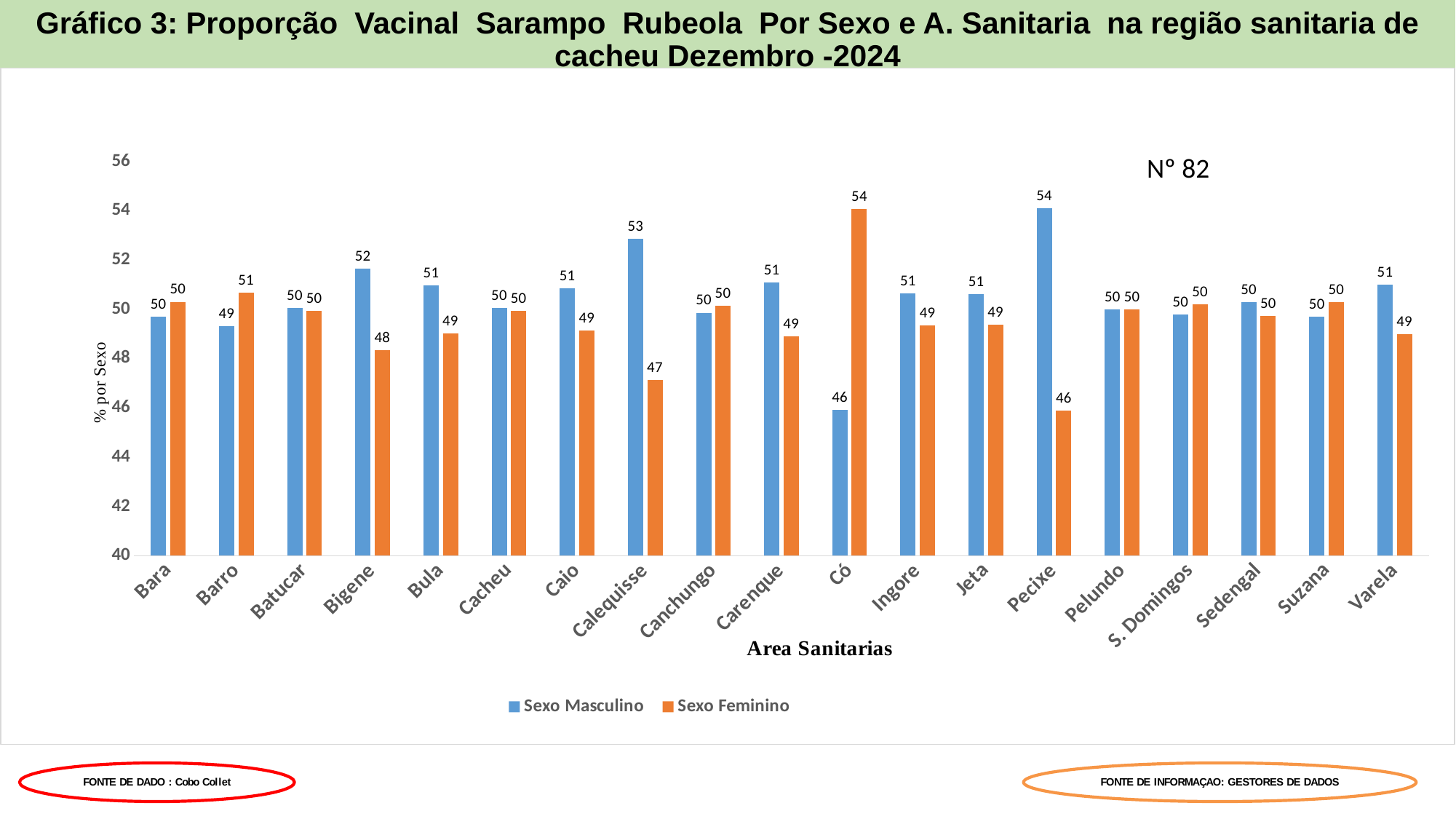
How many series does the legend list? 2 What is the difference between the Sexo Masculino and Sexo Feminino values for Calequisse? 6 What is the Sexo Feminino value for Có? 54 What kind of chart is shown on the slide? bar chart Is the Sexo Masculino value for Có greater or less than 48? less How many areas sanitarias are shown on the x axis? 19 Which area sanitaria has the lowest Sexo Feminino value? Pecixe Which is larger for Có: the Sexo Masculino value or the Sexo Feminino value? Sexo Feminino What is the Sexo Feminino value for Bigene? 48 Which area sanitaria has the highest Sexo Masculino value? Pecixe What is the Sexo Masculino value for Calequisse? 53 Which area sanitaria has the lowest Sexo Masculino value? Có